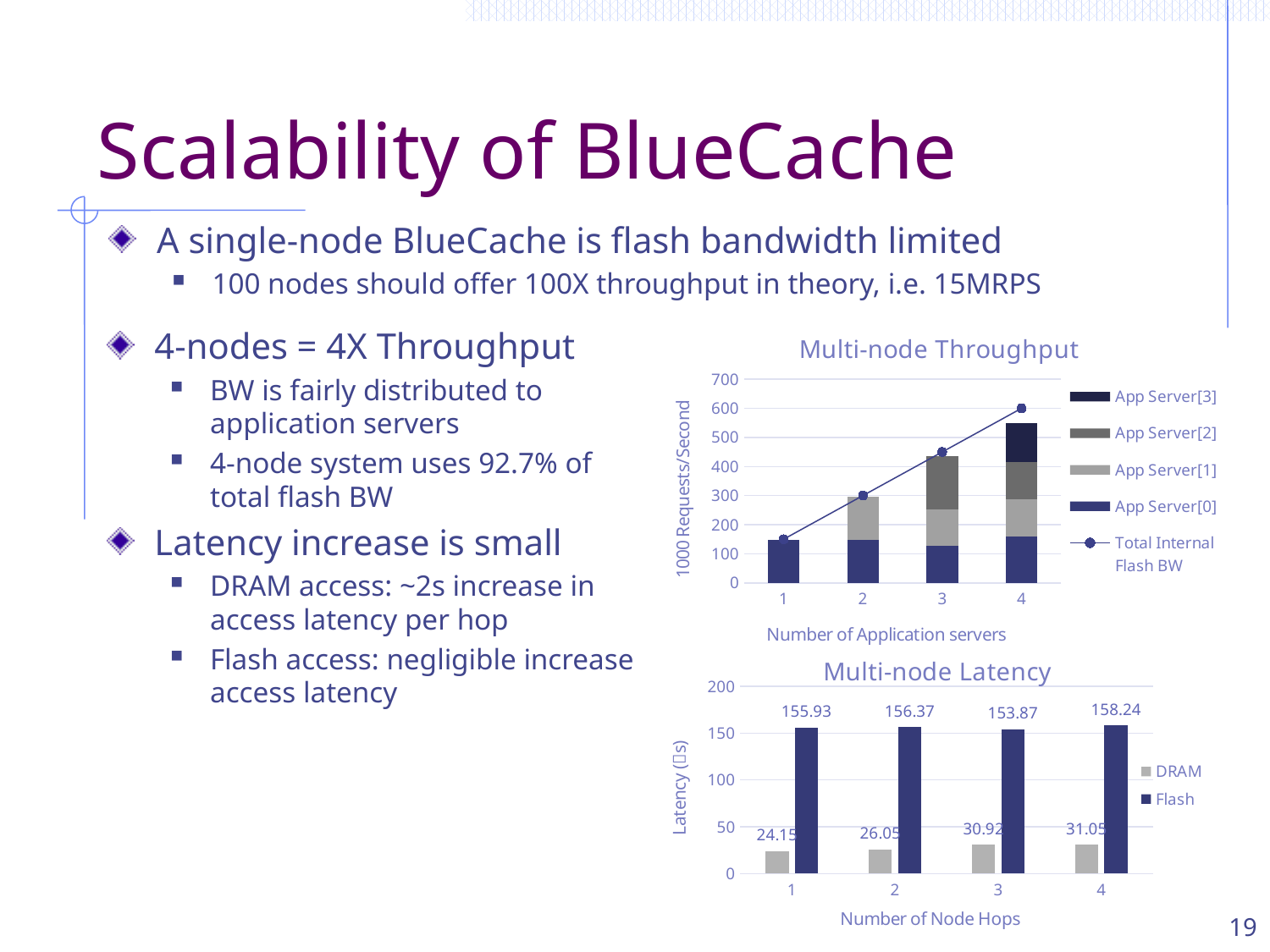
In the Multi-node Latency chart, which number of node hops has the highest Flash latency? 4 In the Multi-node Latency chart, is the Flash latency at 2 hops larger or smaller than at 3 hops? larger In the Multi-node Throughput chart, is the stacked bar total for 1 application server greater or less than 200? less What is the x-axis title of the Multi-node Latency chart? Number of Node Hops In the Multi-node Latency chart, how many series does the legend list? 2 In the Multi-node Latency chart, what is the DRAM latency for 3 node hops? 30.92 In the Multi-node Throughput chart, is the Total Internal Flash BW value for 4 application servers greater or less than 500? greater In the Multi-node Latency chart, which number of node hops has the lowest DRAM latency? 1 In the Multi-node Throughput chart, how many series does the legend list? 5 In the Multi-node Latency chart, what is the Flash latency for 1 node hop? 155.93 In the Multi-node Throughput chart, does the Total Internal Flash BW line rise or fall as the number of application servers increases? rise In the Multi-node Latency chart, what is the difference between the DRAM latency at 4 hops and at 1 hop? 6.9